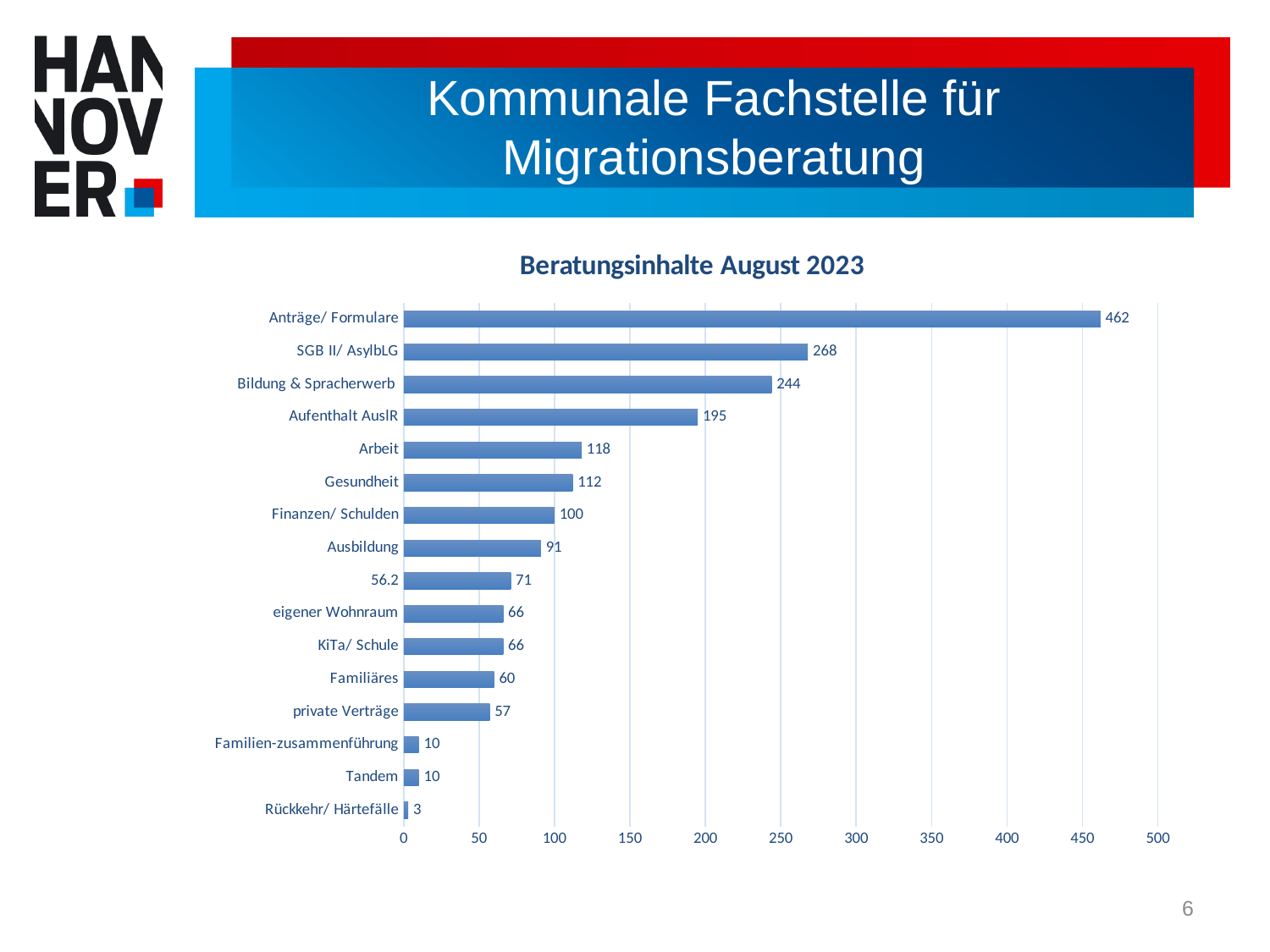
What kind of chart is shown on the slide? bar chart Which category has the highest value? Anträge/ Formulare Is the value for Aufenthalt AuslR greater or less than 200? less How many categories are shown in the chart? 16 Which is larger, the value for Arbeit or the value for Finanzen/ Schulden? Arbeit What is the title of the chart? Beratungsinhalte August 2023 What is the value for Gesundheit? 112 What is the value for Anträge/ Formulare? 462 What is the difference between the values for SGB II/ AsylbLG and Bildung & Spracherwerb? 24 What is the value for private Verträge? 57 What is the difference between the values for Anträge/ Formulare and Aufenthalt AuslR? 267 Which category has the lowest value? Rückkehr/ Härtefälle